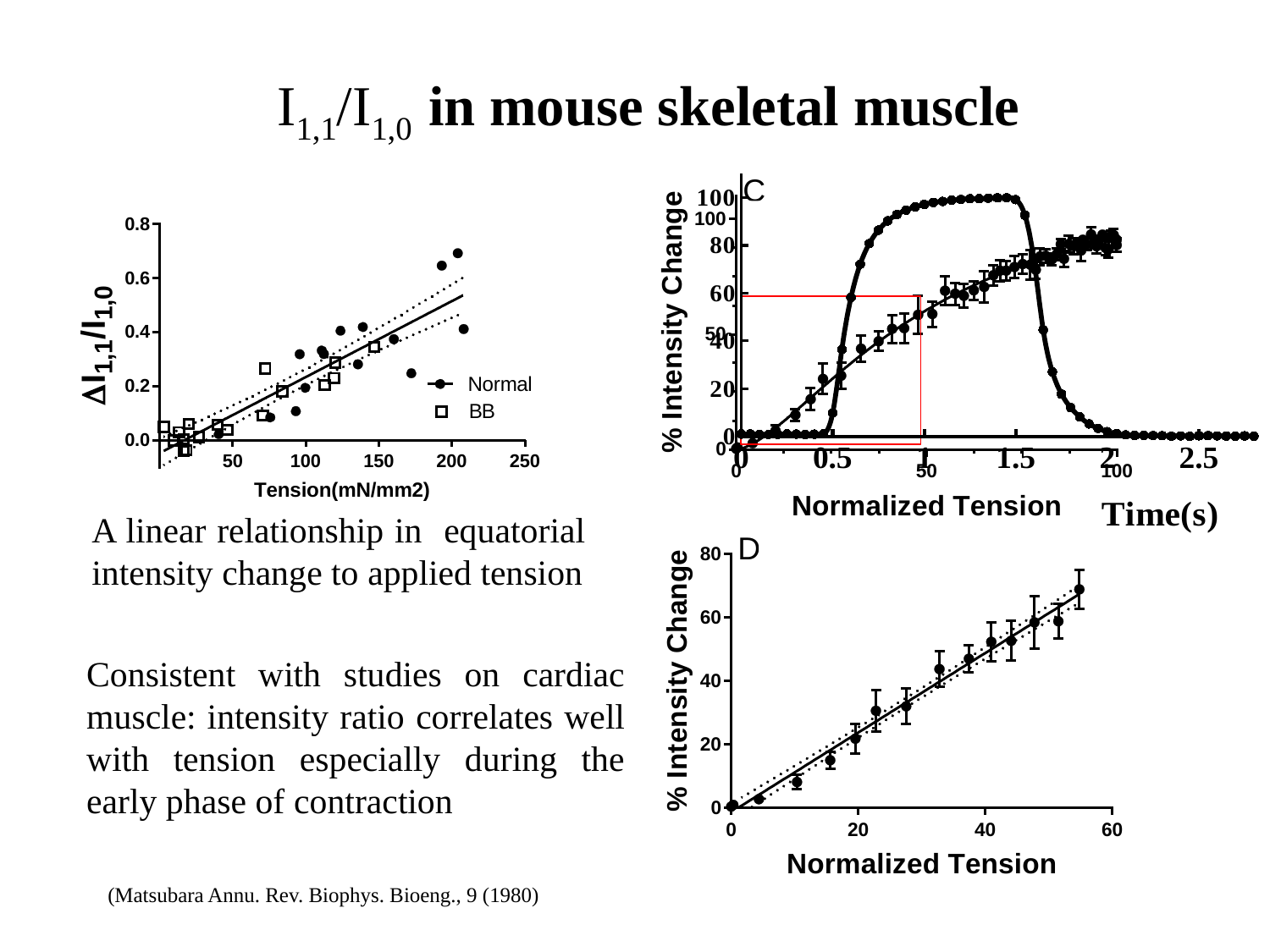
On chart D (bottom right), is the value at Normalized Tension 5 greater or less than 20? less On chart D (bottom right), what is the highest tick value on the Normalized Tension axis? 60 What kind of chart is the left chart showing ΔI1,1/I1,0 against Tension? scatter chart On the left chart (ΔI1,1/I1,0 vs Tension), do the values generally rise or fall as tension increases? rise On the left chart, what is the label of the x axis? Tension(mN/mm2) On the left chart, is the highest Normal value greater or less than 0.6? greater On the left chart (ΔI1,1/I1,0 vs Tension), how many series does the legend list? 2 On chart C (top right), what is the highest tick value shown on the Time(s) axis? 2.5 On chart D (bottom right), do the % Intensity Change values rise or fall as Normalized Tension increases? rise On chart D (bottom right), is the value at the highest Normalized Tension point greater or less than 60? greater On the left chart, what is the highest tick value shown on the Tension axis? 250 On the left chart (ΔI1,1/I1,0 vs Tension), what are the two series named in the legend? Normal and BB